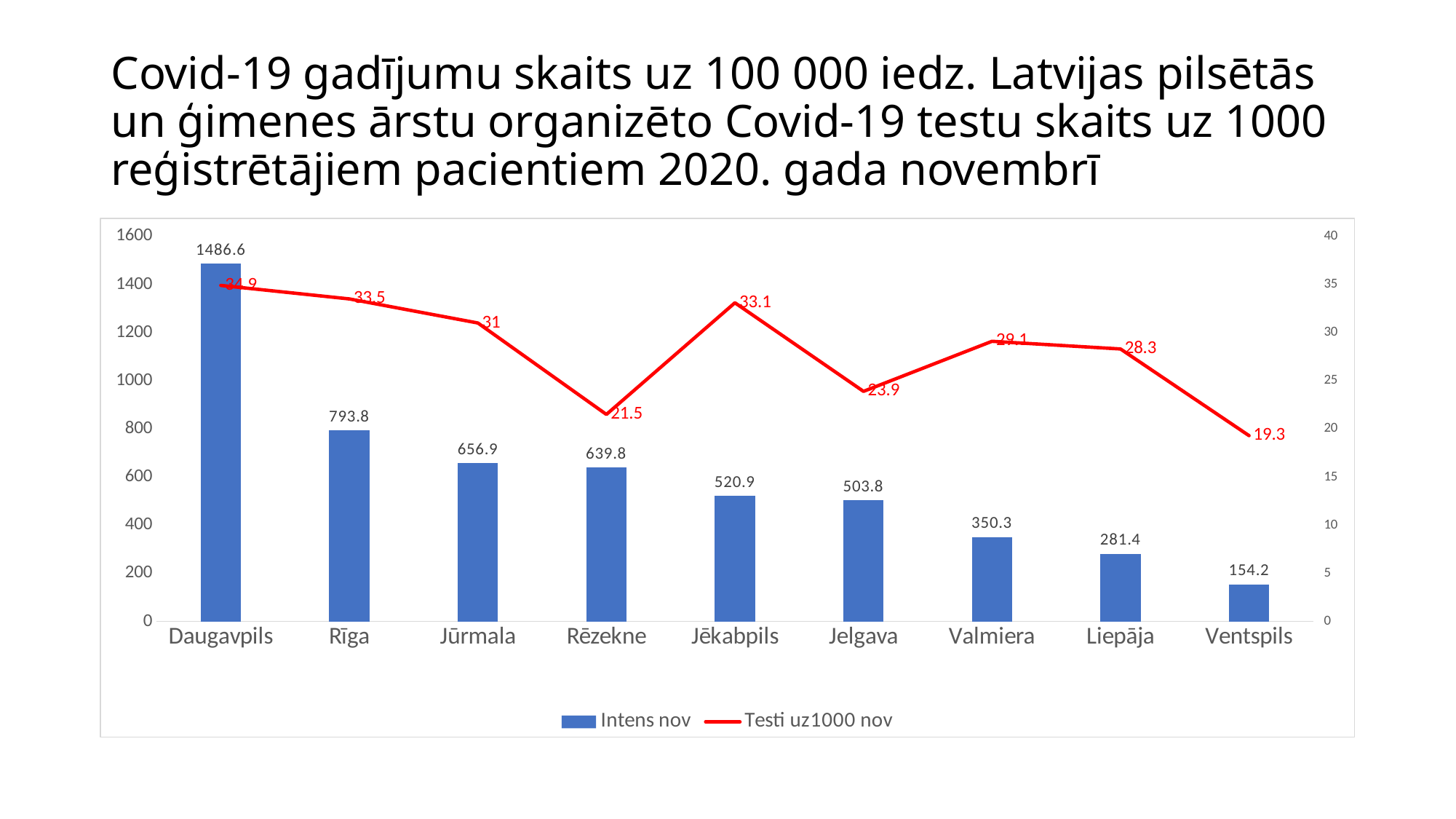
Which series is drawn as a red line? Testi uz1000 nov Which has a higher Testi uz1000 nov value, Jēkabpils or Jelgava? Jēkabpils How many series does the legend list? 2 How many cities are shown on the x axis? 9 What is the difference between the Intens nov values for Rīga and Jūrmala? 136.9 What is the Testi uz1000 nov value for Ventspils? 19.3 What is the Intens nov value for Daugavpils? 1486.6 What is the Testi uz1000 nov value for Rēzekne? 21.5 Do the Intens nov bar values rise or fall from left to right along the x axis? fall Which city has the highest Intens nov value? Daugavpils What is the Intens nov value for Jelgava? 503.8 Which city has the lowest Testi uz1000 nov value? Ventspils